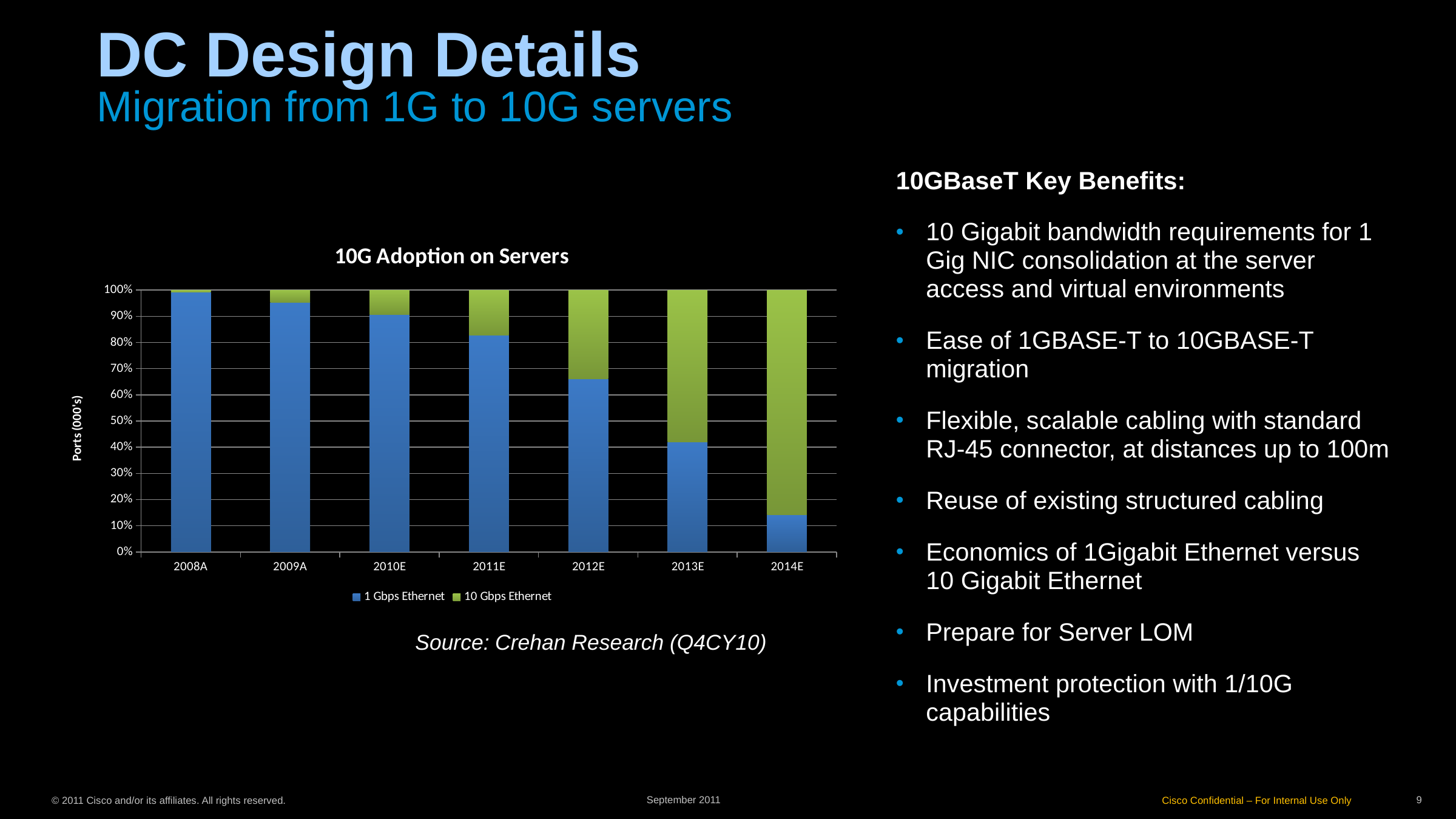
Does the share of 10 Gbps Ethernet ports rise or fall from 2008A to 2014E? rise Is the 1 Gbps Ethernet share for 2014E greater or less than 20%? less What type of chart is shown on the slide? Stacked bar chart How many years are shown on the x axis of the chart? 7 Is the 1 Gbps Ethernet share for 2013E greater or less than 50%? less How many series does the chart legend list? 2 Is the 1 Gbps Ethernet share for 2012E greater or less than 60%? greater Which year has the largest share of 1 Gbps Ethernet ports? 2008A Which year has the smallest share of 1 Gbps Ethernet ports? 2014E What is the title of the chart? 10G Adoption on Servers What is the label on the y axis of the chart? Ports (000's) Which year has a larger share of 10 Gbps Ethernet ports, 2012E or 2013E? 2013E